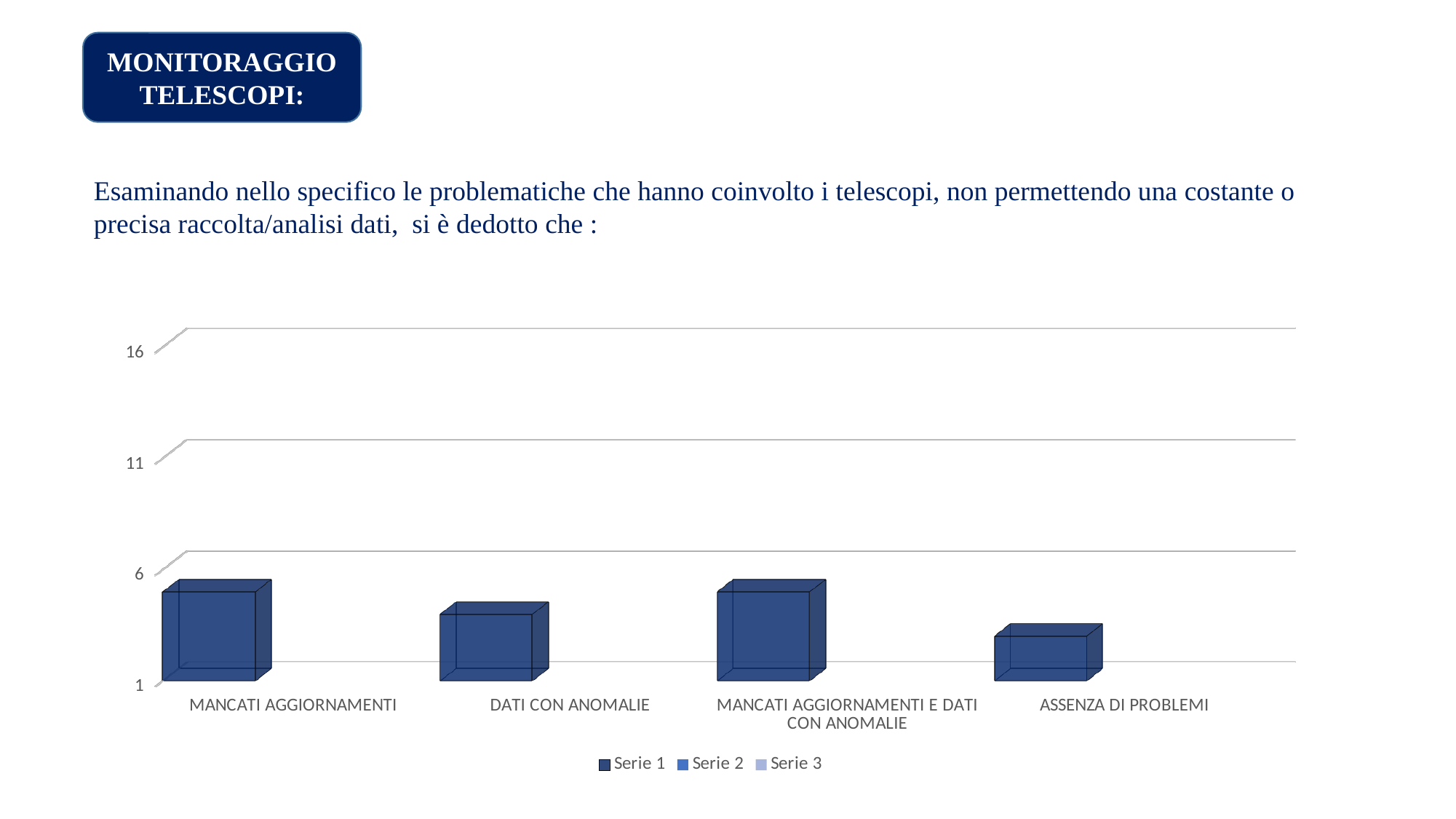
Which is larger, the value for DATI CON ANOMALIE or the value for ASSENZA DI PROBLEMI? DATI CON ANOMALIE Is the value for ASSENZA DI PROBLEMI greater or less than 6? less How many series does the chart legend list? 3 Which is larger, the value for MANCATI AGGIORNAMENTI or the value for ASSENZA DI PROBLEMI? MANCATI AGGIORNAMENTI What are the names of the series listed in the chart legend? Serie 1, Serie 2, Serie 3 Which category has the lowest bar in the chart? ASSENZA DI PROBLEMI Is the value for MANCATI AGGIORNAMENTI E DATI CON ANOMALIE greater or less than 11? less What kind of chart is shown on the slide? Bar chart What is the highest tick value shown on the vertical axis of the chart? 16 Is the value for MANCATI AGGIORNAMENTI greater or less than 6? less How many categories are shown on the x axis of the chart? 4